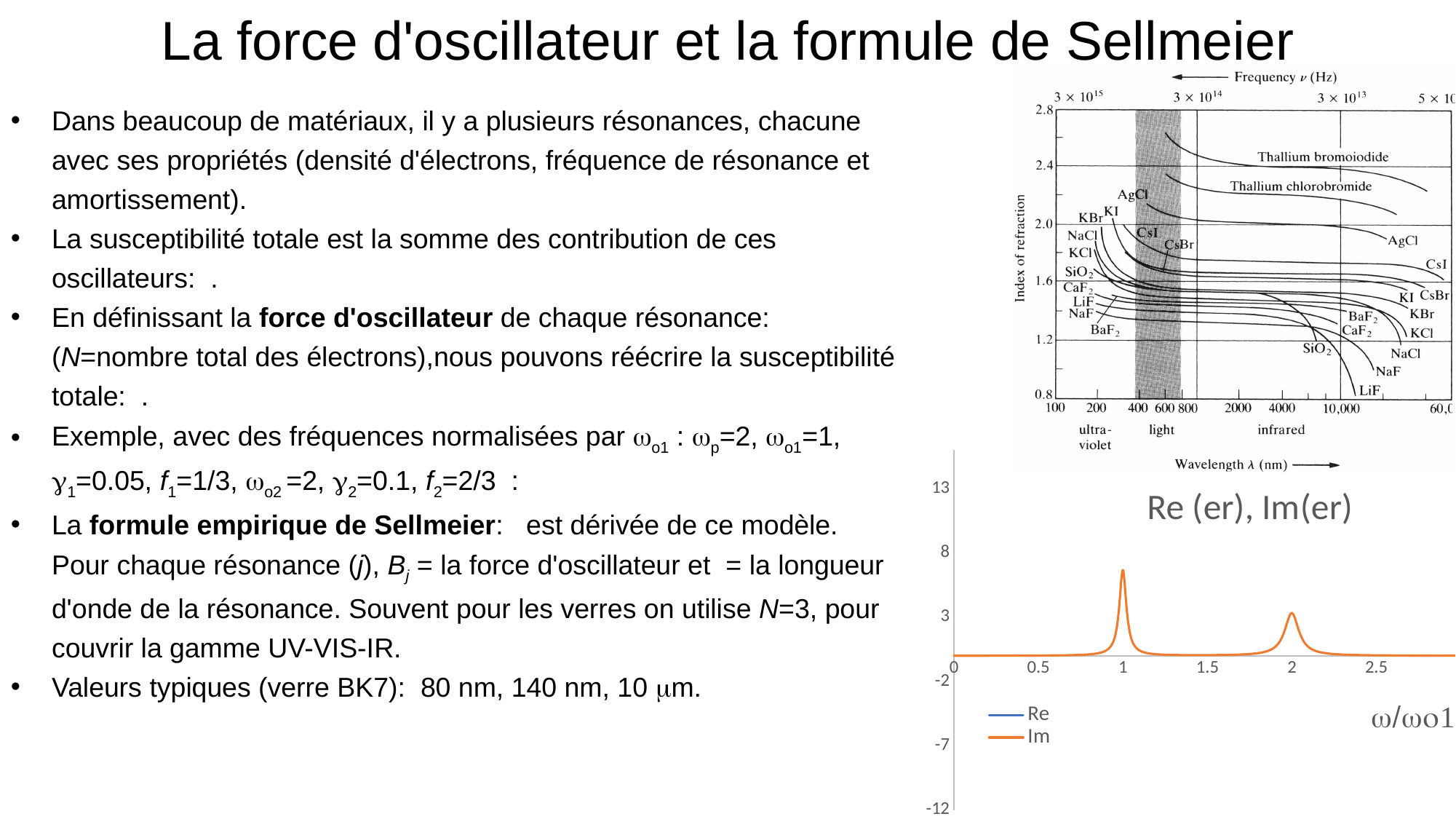
In the bottom-right chart "Re (er), Im(er)", what colour is the Im series drawn in? orange In the bottom-right chart "Re (er), Im(er)", which peak of the Im curve is higher, the one near ω/ωo1 = 1 or the one near ω/ωo1 = 2? the one near ω/ωo1 = 1 In the bottom-right chart "Re (er), Im(er)", how many peaks does the Im curve show? 2 In the bottom-right chart "Re (er), Im(er)", what is the lowest value shown on the vertical axis? -12 How many series does the legend of the bottom-right chart "Re (er), Im(er)" list? 2 In the top-right chart, what is the label of the vertical axis? Index of refraction In the top-right chart of index of refraction, is the index of refraction of LiF in the infrared region greater or less than 1.6? less In the bottom-right chart "Re (er), Im(er)", is the peak of the Im curve near ω/ωo1 = 1 greater or less than 8? less What kind of chart is the bottom-right chart titled "Re (er), Im(er)"? line chart In the bottom-right chart "Re (er), Im(er)", is the peak of the Im curve near ω/ωo1 = 1 greater or less than 3? greater In the top-right chart of index of refraction, which material has the highest index of refraction? Thallium bromoiodide